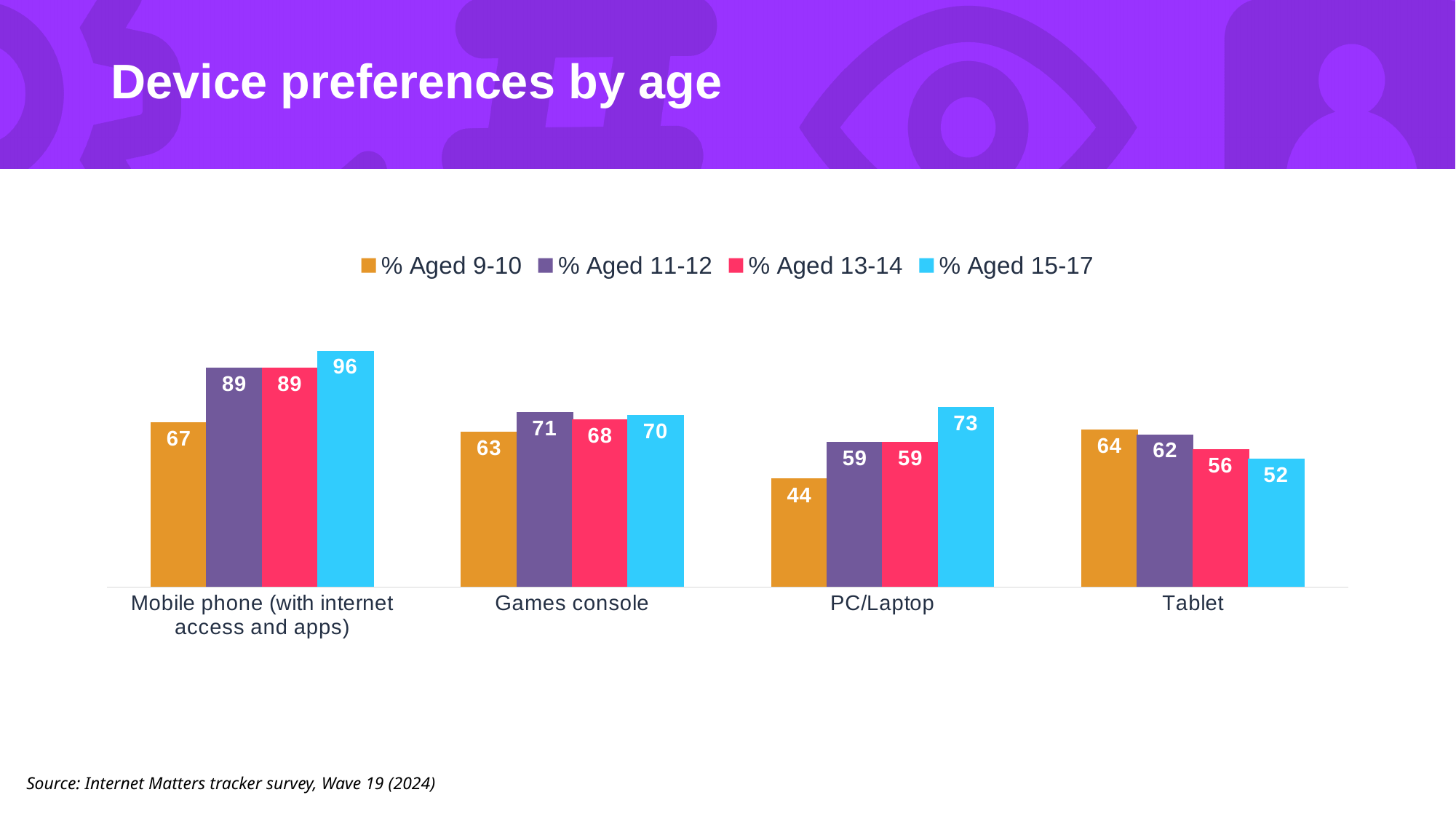
What is the value for % Aged 15-17 for Mobile phone (with internet access and apps)? 96 What is the difference between the % Aged 15-17 and % Aged 9-10 values for PC/Laptop? 29 Which is larger for Games console: the value for % Aged 11-12 or % Aged 13-14? % Aged 11-12 What is the value for % Aged 9-10 for PC/Laptop? 44 What kind of chart is shown on the slide? Bar chart Which device category has the lowest value for % Aged 15-17? Tablet What is the title of the slide? Device preferences by age How many device categories are shown on the x axis? 4 Which device category has the highest value for % Aged 11-12? Mobile phone (with internet access and apps) Do the values for % Aged 15-17 rise or fall from PC/Laptop to Tablet? Fall How many series does the legend list? 4 What is the value for % Aged 13-14 for Tablet? 56